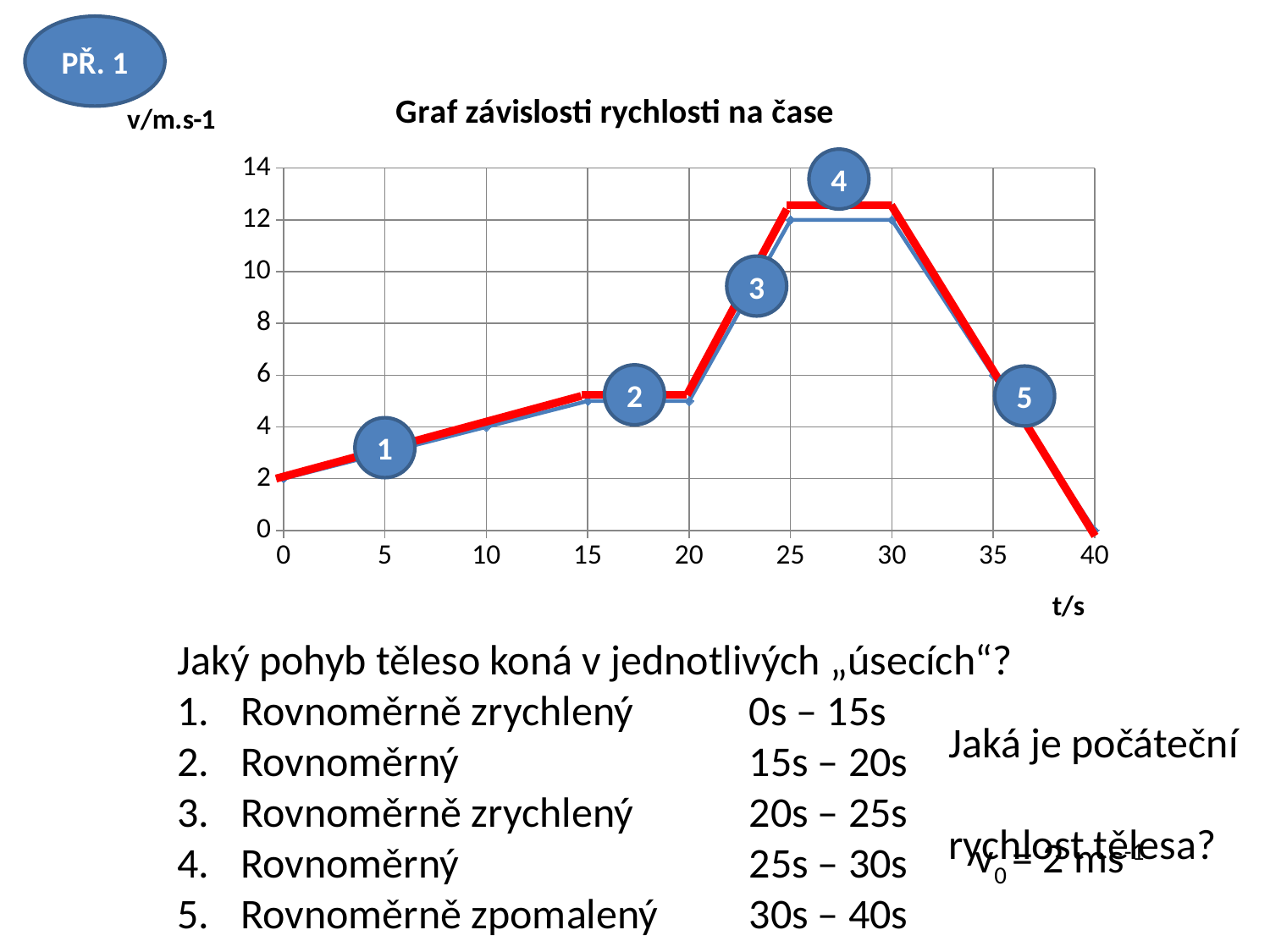
What is the velocity value at t = 10 s? 4 What type of chart is shown on the slide? line chart What is the difference between the velocity at t = 25 s and the velocity at t = 10 s? 8 What is the velocity value at t = 0 s? 2 At which time does the velocity reach its lowest value? 40 Does the velocity rise or fall between t = 30 s and t = 40 s? fall What is the velocity value at t = 25 s? 12 What is the velocity value at t = 40 s? 0 What is the label of the horizontal axis of the chart? t/s What is the highest velocity value reached on the chart? 12 Is the velocity at t = 15 s greater or less than 4? greater What is the title of the chart? Graf závislosti rychlosti na čase